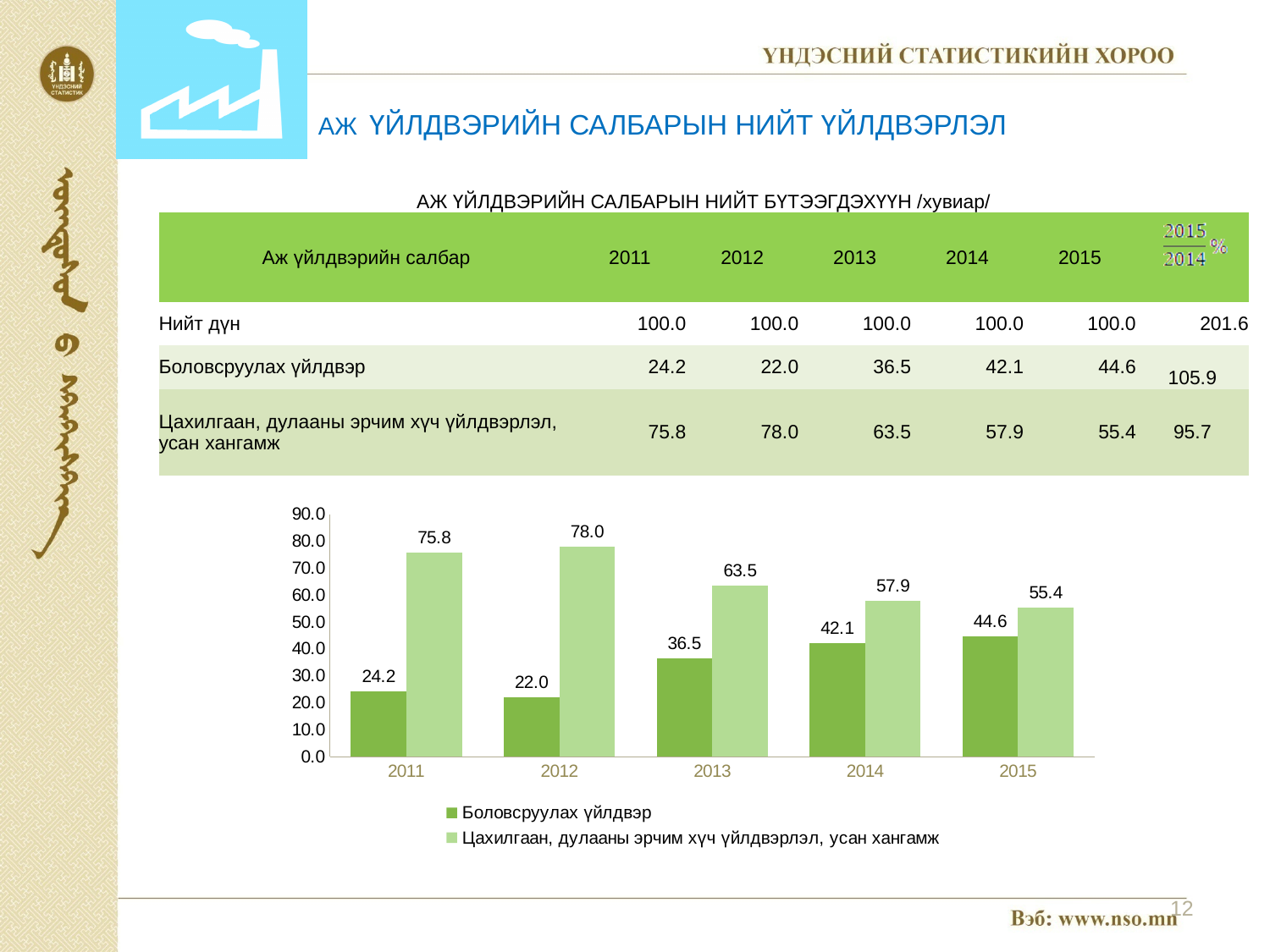
What is the difference between the Боловсруулах үйлдвэр values in 2015 and 2011? 20.4 Does the value for Цахилгаан, дулааны эрчим хүч үйлдвэрлэл, усан хангамж rise or fall from 2012 to 2015? fall What kind of chart is shown on the slide? bar chart What is the value for Боловсруулах үйлдвэр in 2013? 36.5 What is the value for Цахилгаан, дулааны эрчим хүч үйлдвэрлэл, усан хангамж in 2012? 78.0 How many series does the chart legend list? 2 Which series has the larger value in 2011? Цахилгаан, дулааны эрчим хүч үйлдвэрлэл, усан хангамж How many years are shown on the x axis of the chart? 5 In which year is the value for Боловсруулах үйлдвэр highest? 2015 What is the difference between the two series' values in 2014? 15.8 Is the value for Боловсруулах үйлдвэр in 2012 greater or less than 30.0? less In which year is the value for Цахилгаан, дулааны эрчим хүч үйлдвэрлэл, усан хангамж lowest? 2015